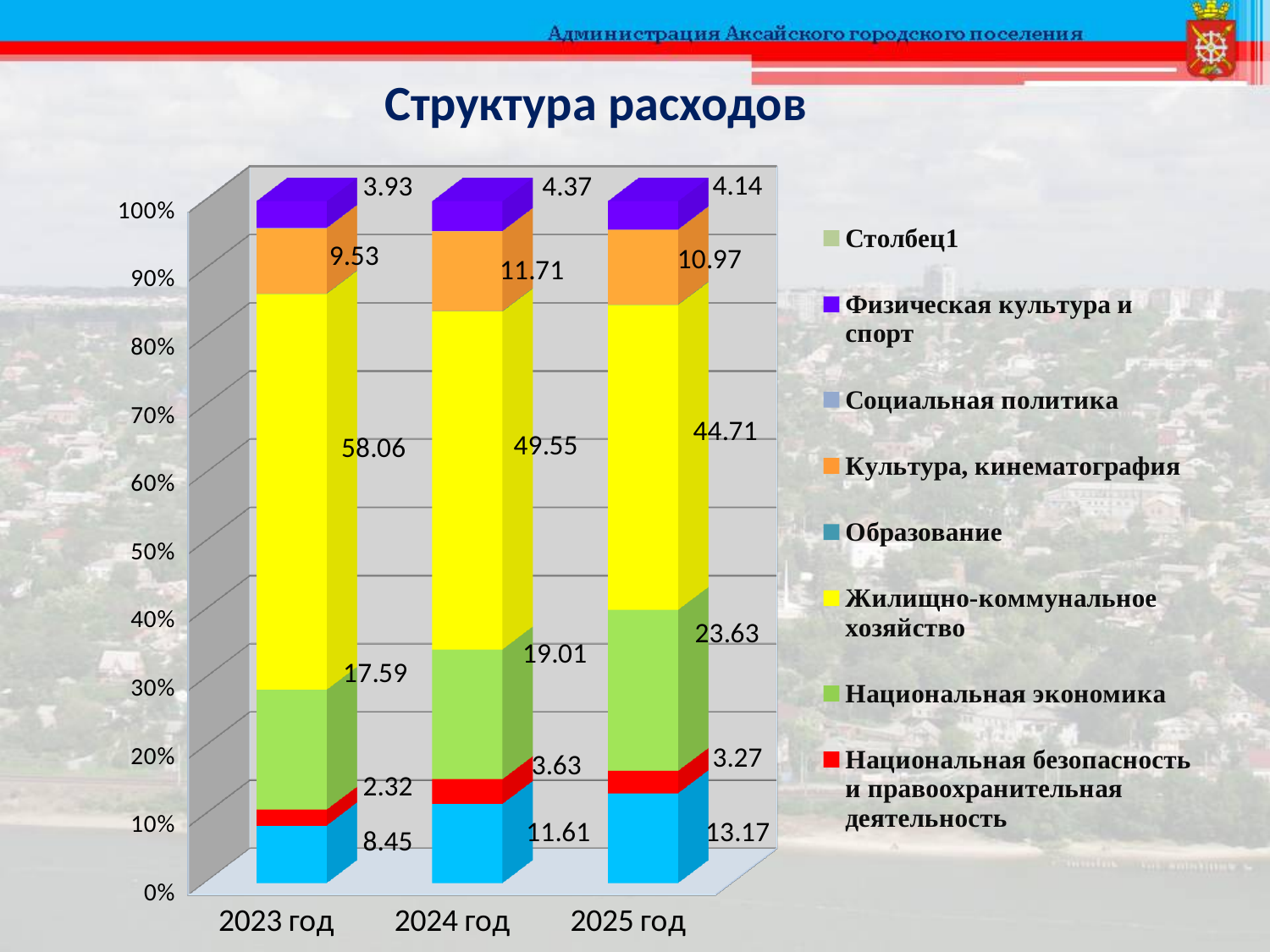
What is the value of the Культура, кинематография segment for 2024 год? 11.71 In which year is the Жилищно-коммунальное хозяйство segment the largest? 2023 год What is the value of the Физическая культура и спорт segment for 2025 год? 4.14 How many entries does the chart legend list? 8 Which year has the larger Национальная экономика value, 2024 год or 2025 год? 2025 год By how much does the Жилищно-коммунальное хозяйство value for 2023 год exceed that for 2025 год? 13.35 How many years are shown on the x axis of the chart? 3 Does the Жилищно-коммунальное хозяйство share rise or fall from 2023 год to 2025 год? It falls What is the value of the Национальная экономика segment for 2025 год? 23.63 What is the value of the Жилищно-коммунальное хозяйство segment for 2023 год? 58.06 What is the difference between the Национальная экономика values for 2025 год and 2023 год? 6.04 In which year is the Национальная безопасность и правоохранительная деятельность segment the smallest? 2023 год